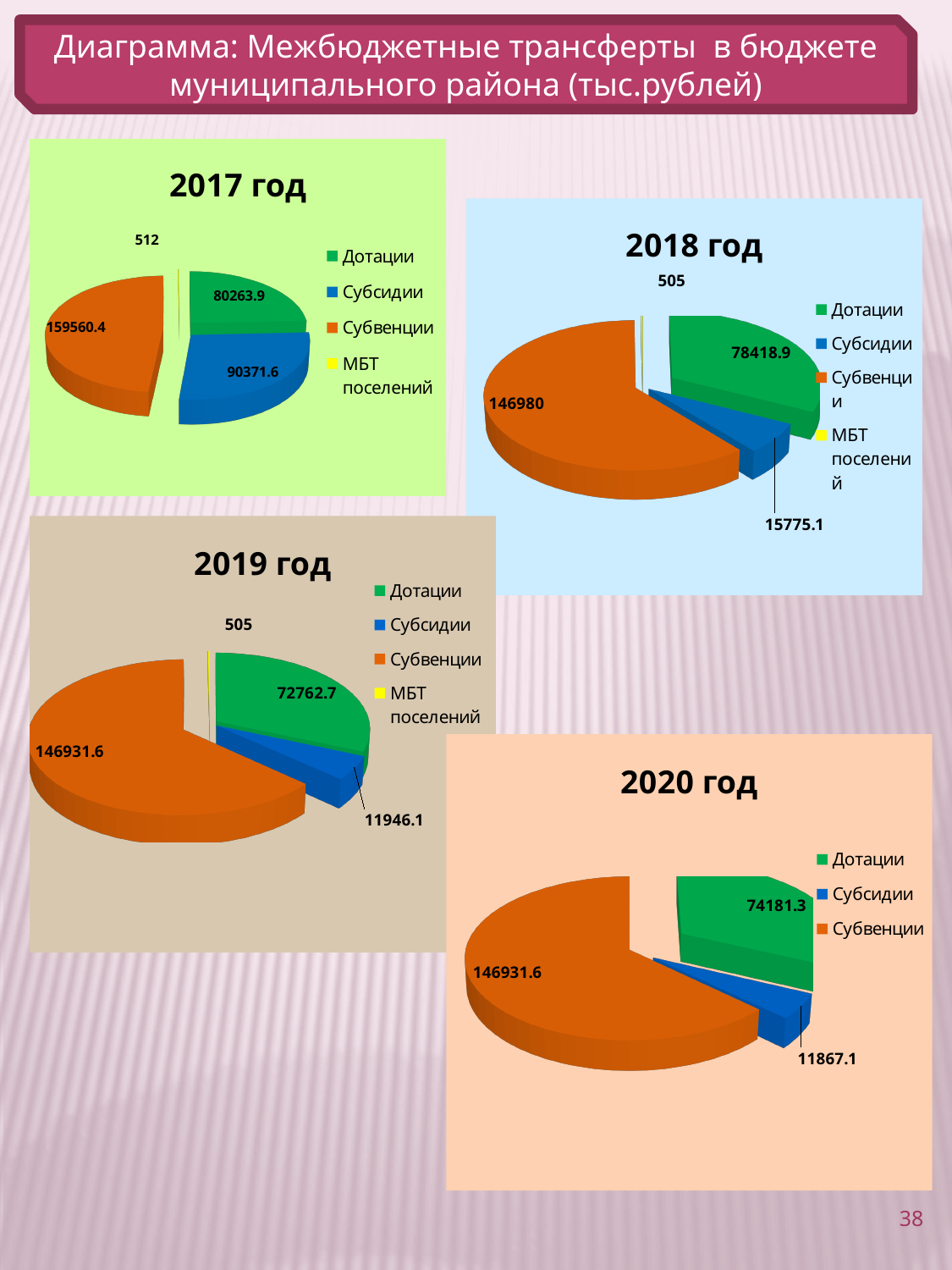
How many legend entries does the 2020 год chart list? 3 In the 2019 год chart, what is the value for Дотации? 72762.7 In the 2020 год chart, what is the value for Субсидии? 11867.1 In the 2020 год chart, which is larger, Дотации or Субсидии? Дотации In the 2019 год chart, what colour represents Субвенции? Orange What type of chart is the 2018 год chart? Pie chart In the 2017 год chart, what is the value for Субвенции? 159560.4 In the 2018 год chart, what is the value for Субсидии? 15775.1 In the 2017 год chart, which category has the largest value? Субвенции How many slices does the 2019 год chart have? 4 In the 2018 год chart, which category has the smallest value? МБТ поселений In the 2017 год chart, what is the difference between Субсидии and Дотации? 10107.7